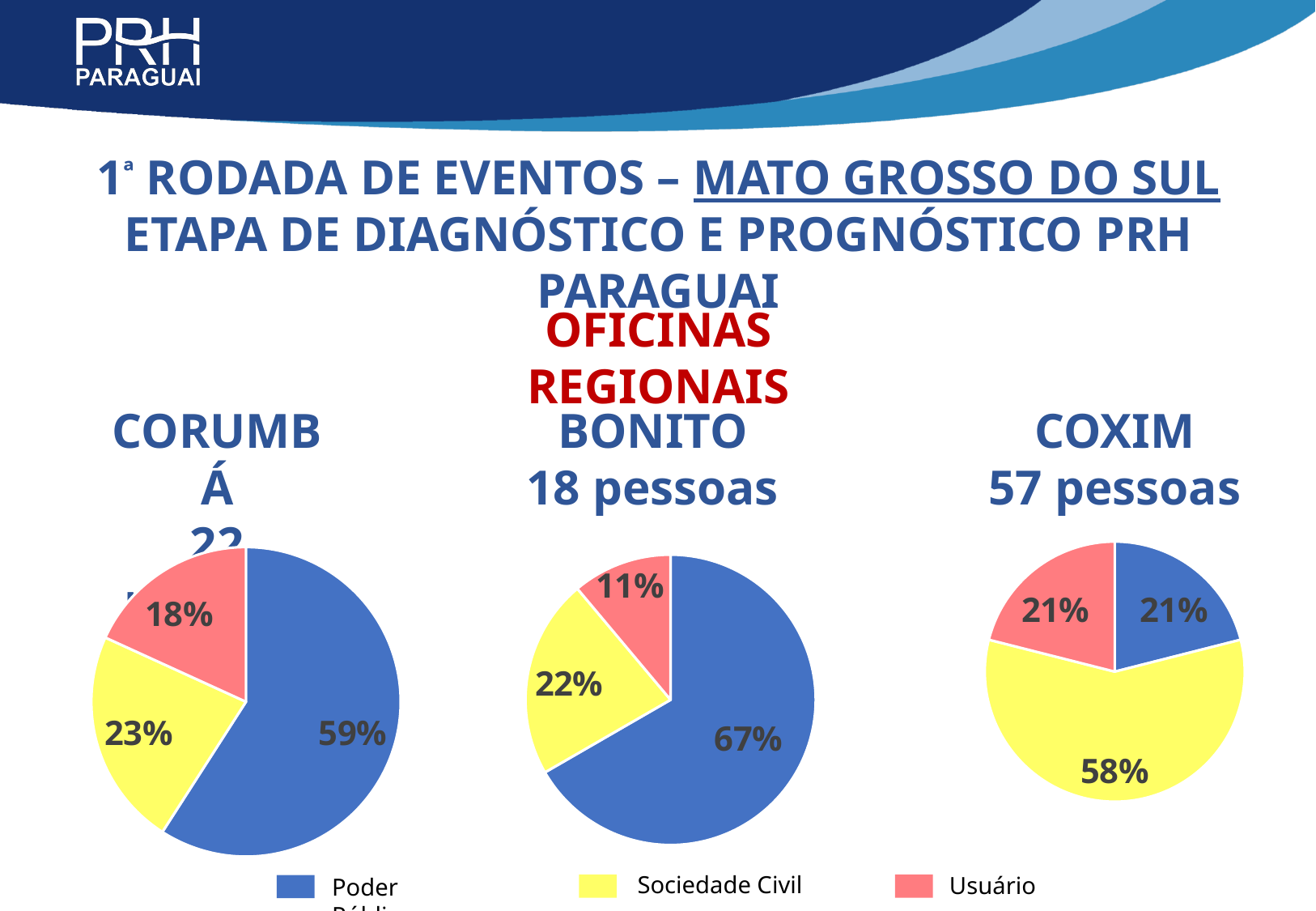
How many slices does the COXIM pie chart have? 3 In the COXIM pie chart, which category has the largest slice? Sociedade Civil How many entries does the shared legend list? 3 In the CORUMBÁ pie chart, which category has the largest slice? Poder Público In the CORUMBÁ pie chart, which is larger: the Sociedade Civil slice or the Usuário slice? Sociedade Civil In the BONITO pie chart, what share is shown for Usuário? 11% In the BONITO pie chart, what share is shown for Sociedade Civil? 22% What type of chart is used for BONITO? Pie chart In the COXIM pie chart, what share is shown for Sociedade Civil? 58% In the CORUMBÁ pie chart, what share is shown for Usuário? 18% In the BONITO pie chart, what is the difference between the Poder Público share and the Sociedade Civil share? 45% In the BONITO pie chart, which category has the smallest slice? Usuário